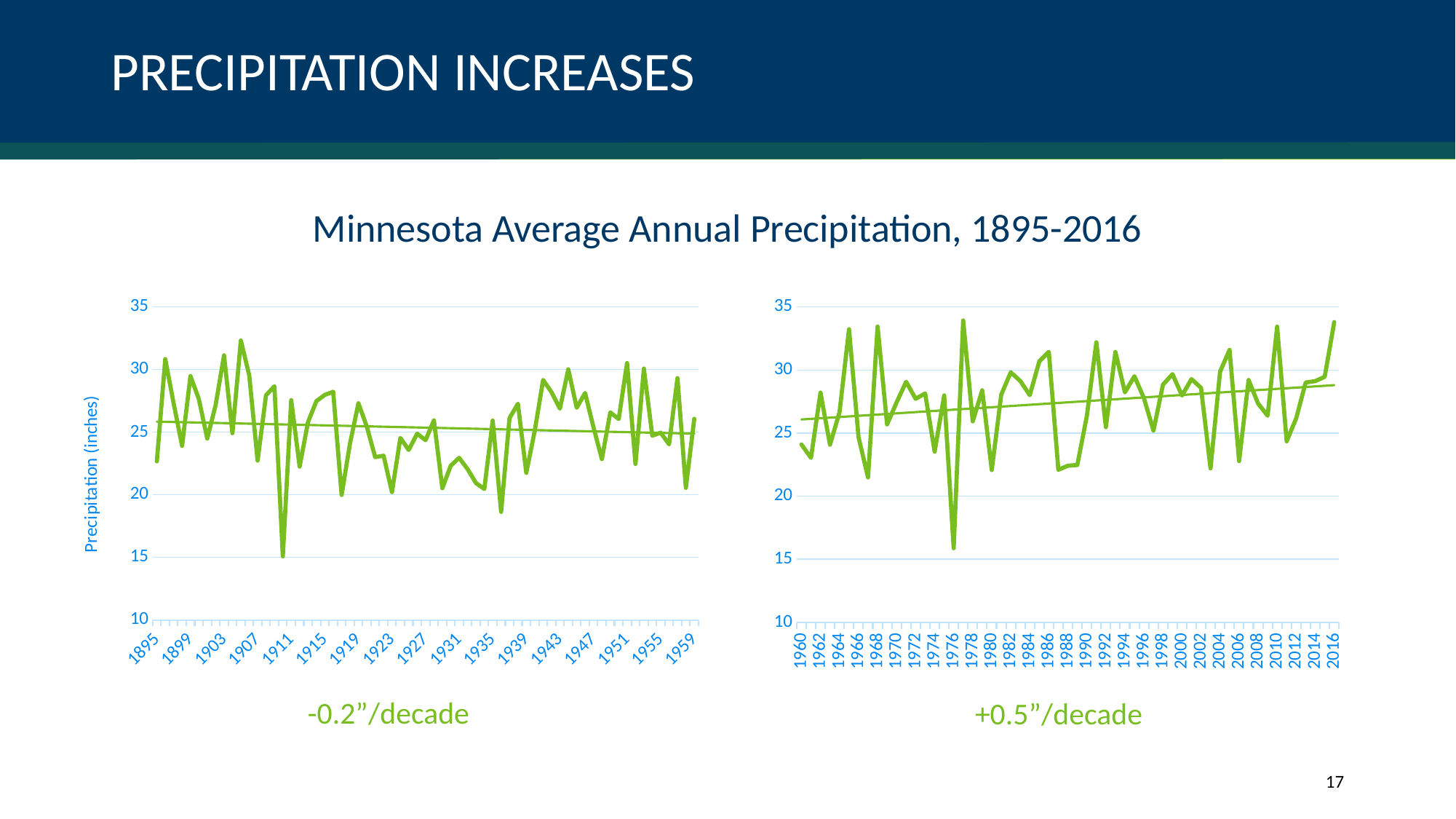
On the right chart (1960-2016), is the highest value greater or less than 30? greater On the left chart (1895-1959), is the lowest value greater or less than 20? less On the left chart (1895-1959), does the trend line rise or fall along the x axis? fall On the right chart (1960-2016), does the trend line rise or fall along the x axis? rise On the right chart (1960-2016), is the lowest value greater or less than 20? less What kind of chart is shown on the left side of the slide? line chart What kind of chart is shown on the right side of the slide? line chart What rate of change is printed below the right chart (1960-2016)? +0.5"/decade What is the overall title shown above the two charts? Minnesota Average Annual Precipitation, 1895-2016